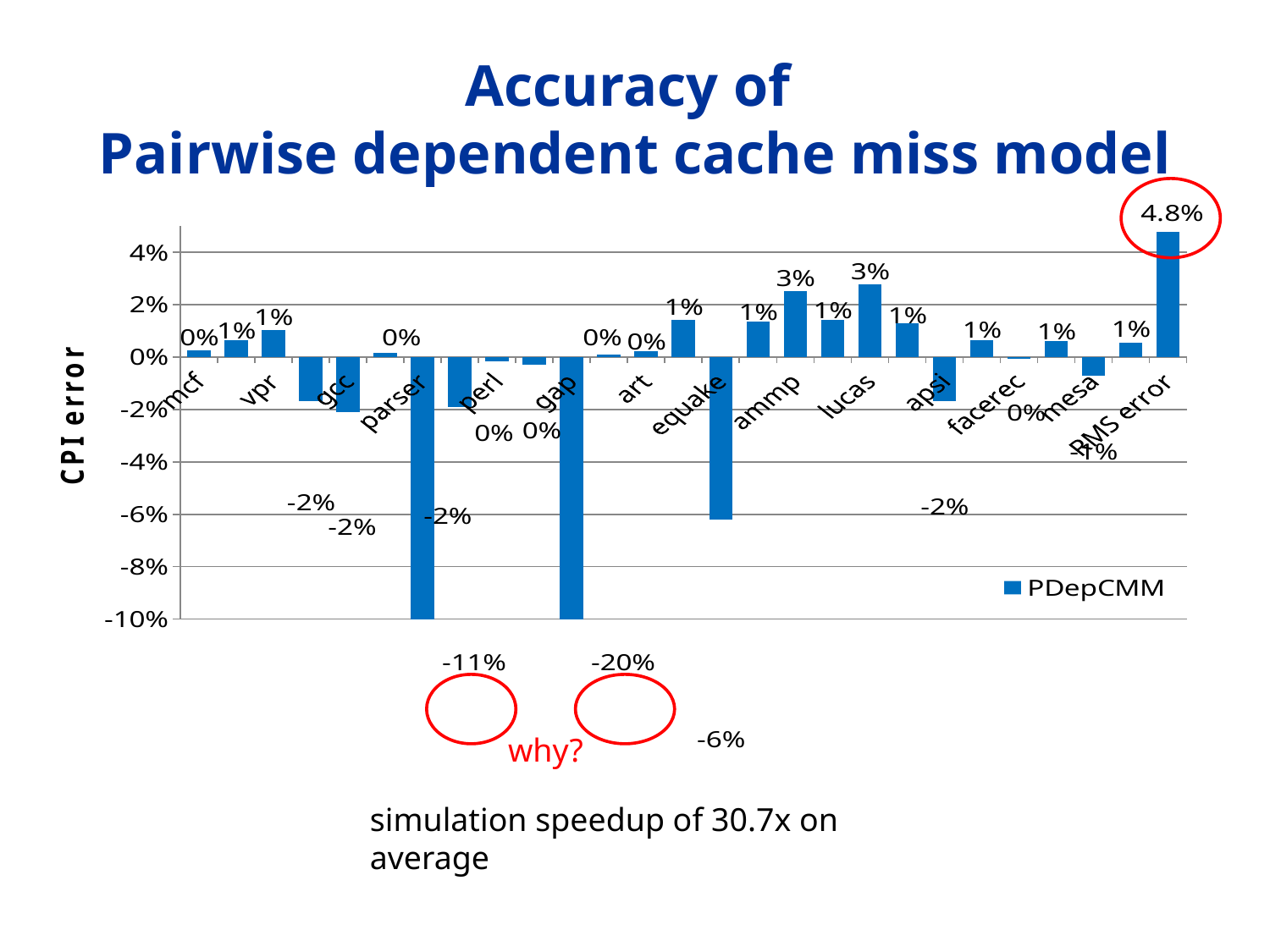
What is the CPI error value for parser? -11% What is the CPI error value for gcc? -2% What is the CPI error value for RMS error? 4.8% How many series does the legend list? 1 What is the name of the series shown in the legend? PDepCMM Which category has the lowest (most negative) CPI error? gap Is the CPI error for gap greater or less than -10%? less What type of chart is shown on the slide? bar chart What is the CPI error value for vpr? 1% Which category has the highest CPI error? RMS error What is the CPI error value for gap? -20% Which has a larger CPI error magnitude, gap or parser? gap